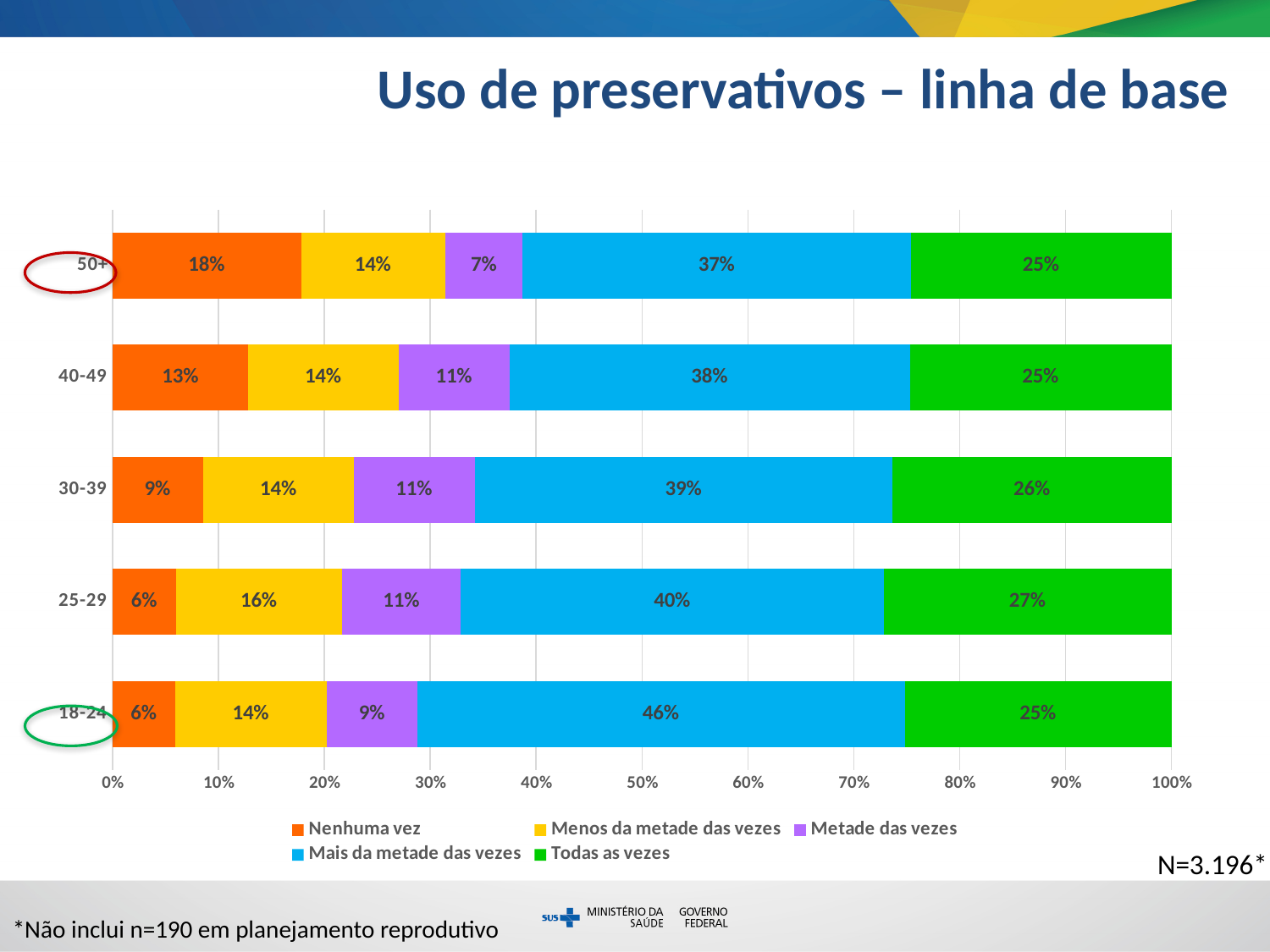
What is the difference between the "Nenhuma vez" values for the 50+ and 18-24 age groups? 12% What is the value for "Todas as vezes" in the 25-29 age group? 27% How many age groups are shown in the chart? 5 Which age group has the highest value for "Nenhuma vez"? 50+ What colour represents "Todas as vezes" in the chart? Green How many series does the legend list? 5 Which age group has the highest value for "Mais da metade das vezes"? 18-24 What type of chart is shown on the slide? Stacked bar chart What is the value for "Mais da metade das vezes" in the 18-24 age group? 46% Which age group has the lowest value for "Metade das vezes"? 50+ Which age group has a larger "Mais da metade das vezes" value, 18-24 or 50+? 18-24 What percentage of the 50+ age group answered "Nenhuma vez"? 18%